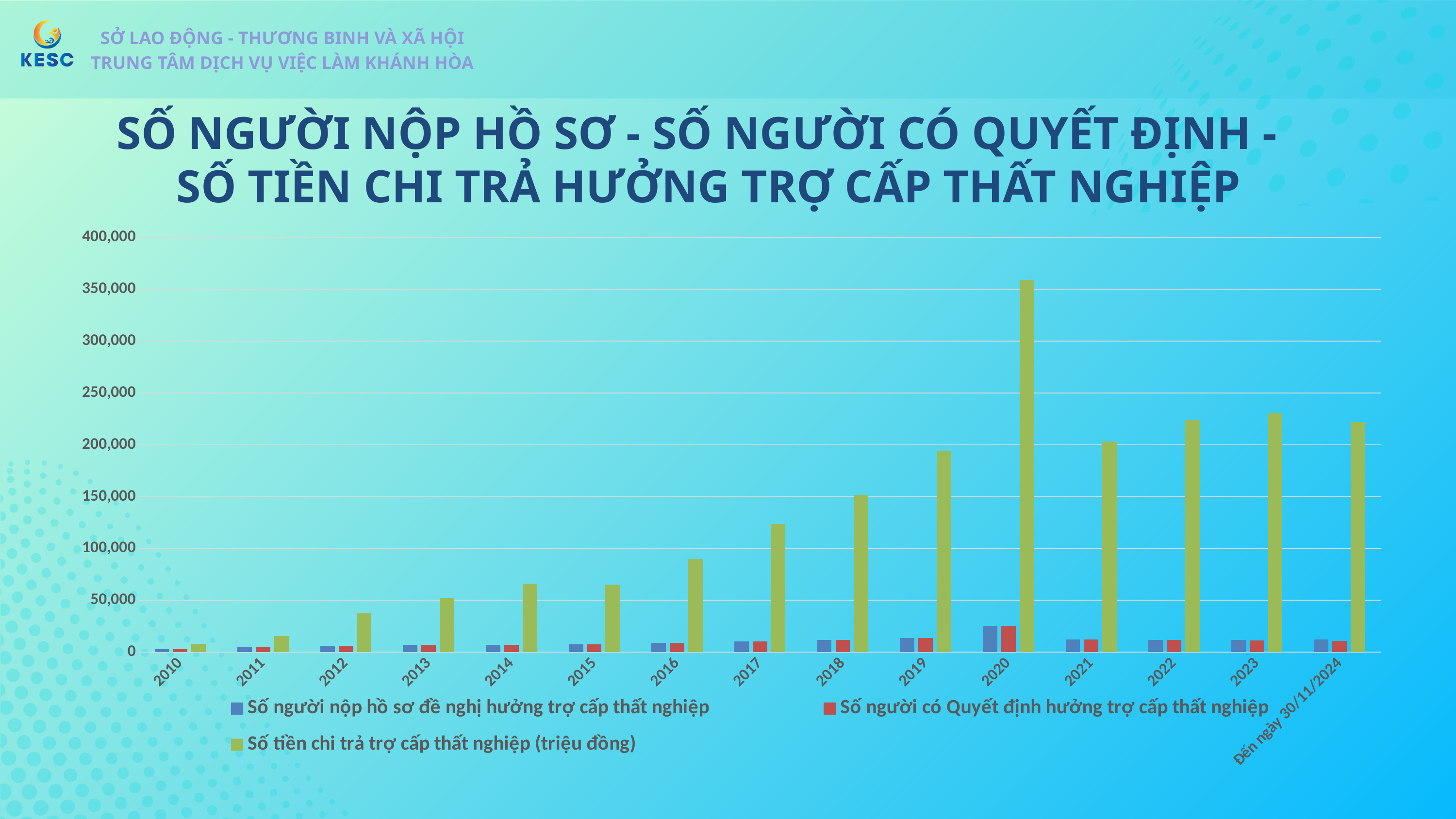
Is the value for 'Số tiền chi trả trợ cấp thất nghiệp (triệu đồng)' in 2016 greater or less than 100,000? less In which year is the bar for 'Số tiền chi trả trợ cấp thất nghiệp (triệu đồng)' the highest? 2020 What colour are the bars for 'Số tiền chi trả trợ cấp thất nghiệp (triệu đồng)'? green Which year has the larger value for 'Số tiền chi trả trợ cấp thất nghiệp (triệu đồng)', 2020 or 2021? 2020 How many series does the legend list? 3 Is the value for 'Số tiền chi trả trợ cấp thất nghiệp (triệu đồng)' in 2017 greater or less than 100,000? greater Is the value for 'Số tiền chi trả trợ cấp thất nghiệp (triệu đồng)' in 2012 greater or less than 50,000? less What kind of chart is shown on the slide? bar chart How many categories are shown along the x axis? 15 In which year is the bar for 'Số tiền chi trả trợ cấp thất nghiệp (triệu đồng)' the lowest? 2010 Does the value for 'Số tiền chi trả trợ cấp thất nghiệp (triệu đồng)' rise or fall from 2010 to 2020? rise